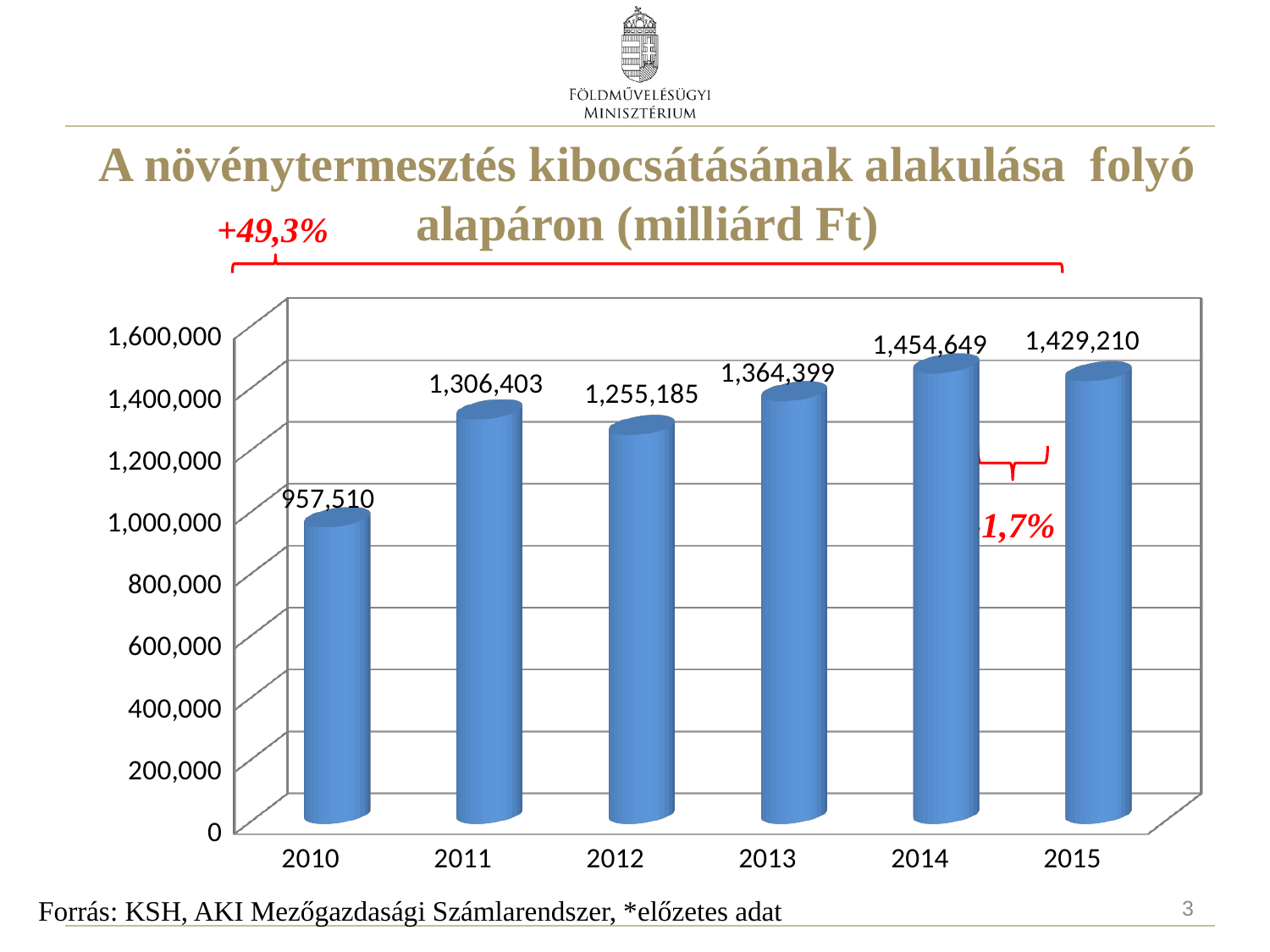
Which year has the highest value? 2014 What kind of chart is shown on the slide? bar chart Is the value for 2010 greater or less than 1,000,000? less What is the difference between the values for 2013 and 2012? 109,214 Which is larger, the value for 2011 or the value for 2012? 2011 What is the value for 2014? 1,454,649 What is the value for 2015? 1,429,210 What is the value for 2010? 957,510 How many years are shown on the x axis? 6 Does the value rise or fall from 2014 to 2015? fall What is the difference between the values for 2014 and 2015? 25,439 Which year has the lowest value? 2010